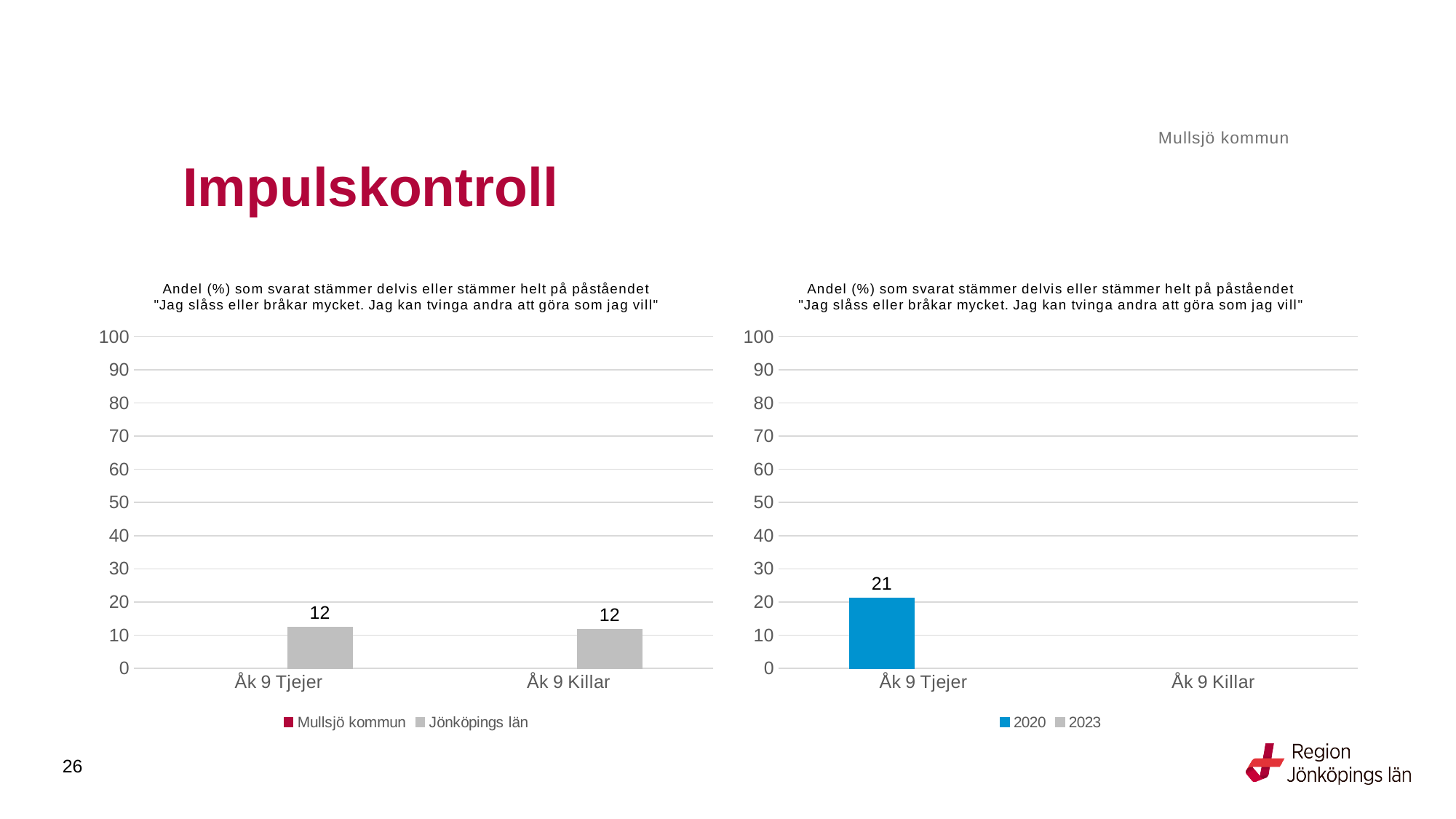
What kind of chart is the right chart? Bar chart In the left chart, is the value for Jönköpings län for Åk 9 Killar greater or less than 20? less How many series does the legend of the left chart list? 2 How many series does the legend of the right chart list? 2 In the left chart, what is the difference between the Jönköpings län values for Åk 9 Tjejer and Åk 9 Killar? 0 Which series are listed in the legend of the left chart? Mullsjö kommun and Jönköpings län How many categories are shown on the x axis of the left chart? 2 In the right chart, what is the value for 2020 for Åk 9 Tjejer? 21 In the left chart, what is the value for Jönköpings län for Åk 9 Killar? 12 Which series are listed in the legend of the right chart? 2020 and 2023 In the left chart, what is the value for Jönköpings län for Åk 9 Tjejer? 12 In the right chart, is the value for 2020 for Åk 9 Tjejer greater or less than 30? less